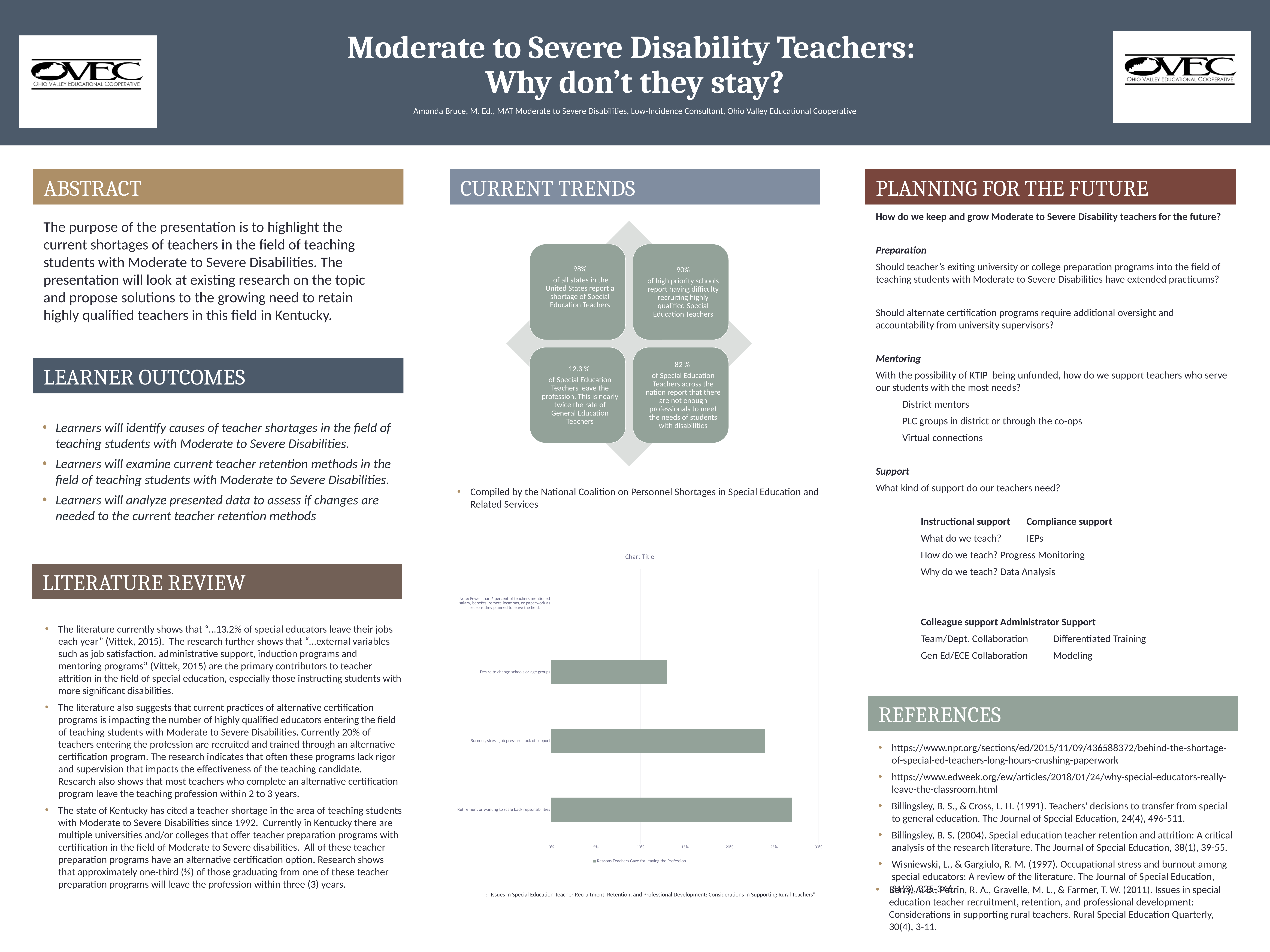
Which is larger: the value for 'Burnout, stress, job pressure, lack of support' or the value for 'Desire to change schools or age groups'? Burnout, stress, job pressure, lack of support Is the value for 'Desire to change schools or age groups' greater or less than 10%? greater Is the value for 'Retirement or wanting to scale back responsibilities' greater or less than 30%? less How many bars are plotted in the chart? 3 What kind of chart is shown under the Current Trends section? bar chart Is the value for 'Burnout, stress, job pressure, lack of support' greater or less than 20%? greater Which reason for leaving the profession has the shortest bar in the chart? Desire to change schools or age groups What is the legend entry shown below the chart? Reasons Teachers Gave for leaving the Profession Which reason for leaving the profession has the longest bar in the chart? Retirement or wanting to scale back responsibilities How many series does the chart legend list? 1